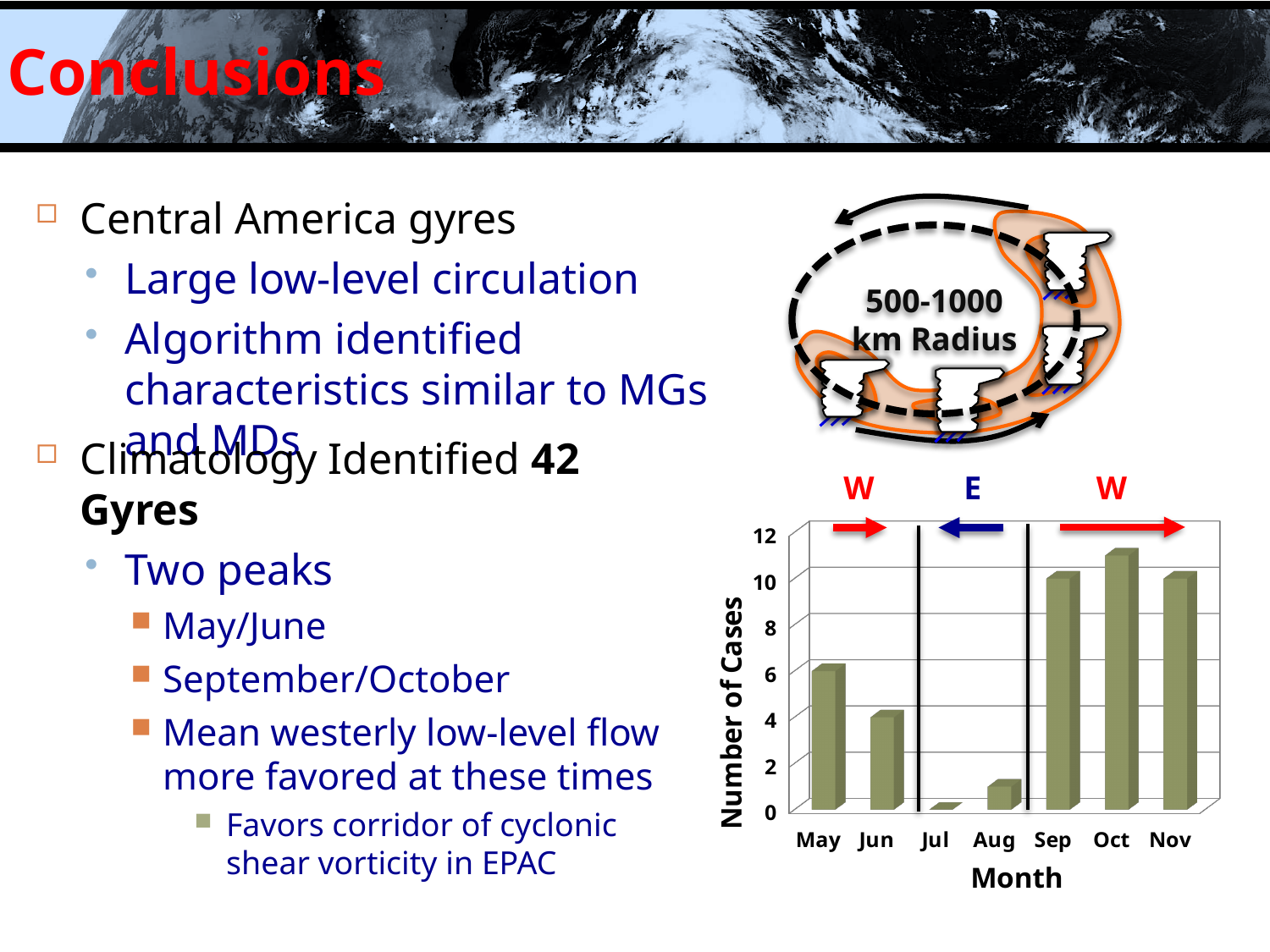
What kind of chart is shown on the slide? bar chart How many months are shown on the x axis of the chart? 7 What is the label of the y axis of the chart? Number of Cases Which month has the highest number of cases? Oct What is the number of cases for Jun? 4 Which month has the lowest number of cases? Jul Is the number of cases for Oct greater or less than 10? greater What is the difference in number of cases between May and Jun? 2 Which month has more cases, Sep or Jun? Sep Is the number of cases for Aug greater or less than 2? less What is the number of cases for May? 6 What is the number of cases for Sep? 10